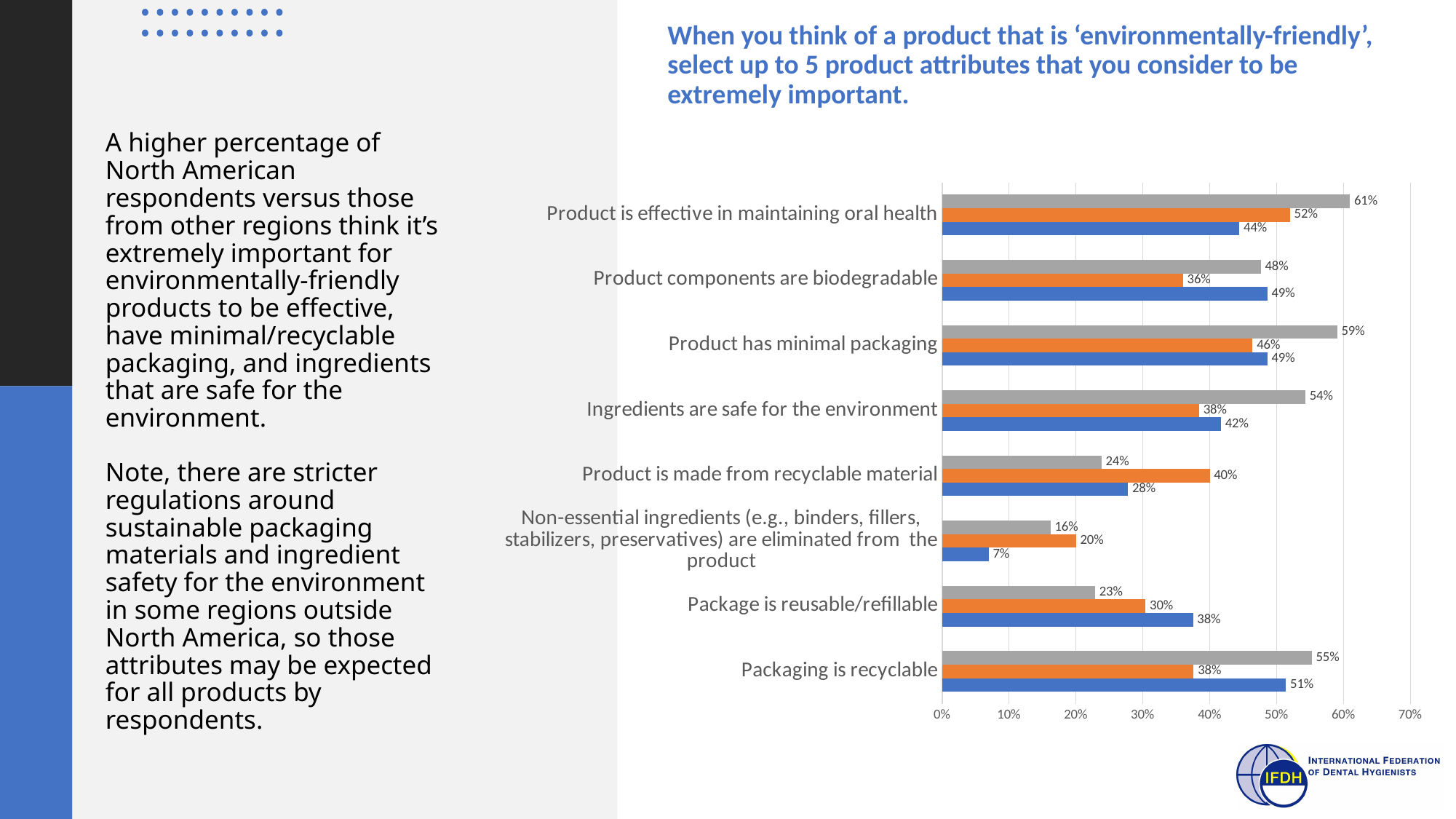
Which category has the lowest blue bar value? Non-essential ingredients (e.g., binders, fillers, stabilizers, preservatives) are eliminated from the product How many product attribute categories are shown on the chart? 8 What type of chart is shown on the slide? bar chart How many bars are plotted for each category? 3 What is the blue bar value for 'Non-essential ingredients (e.g., binders, fillers, stabilizers, preservatives) are eliminated from the product'? 7% What is the difference between the gray and blue bar values for 'Product is effective in maintaining oral health'? 17% Is the gray bar value for 'Product has minimal packaging' greater or less than 50%? greater Which category has the highest gray bar value? Product is effective in maintaining oral health What is the blue bar value for 'Packaging is recyclable'? 51% What is the orange bar value for 'Product is made from recyclable material'? 40% For 'Package is reusable/refillable', which is larger: the blue bar or the gray bar? the blue bar What is the gray bar value for 'Product is effective in maintaining oral health'? 61%